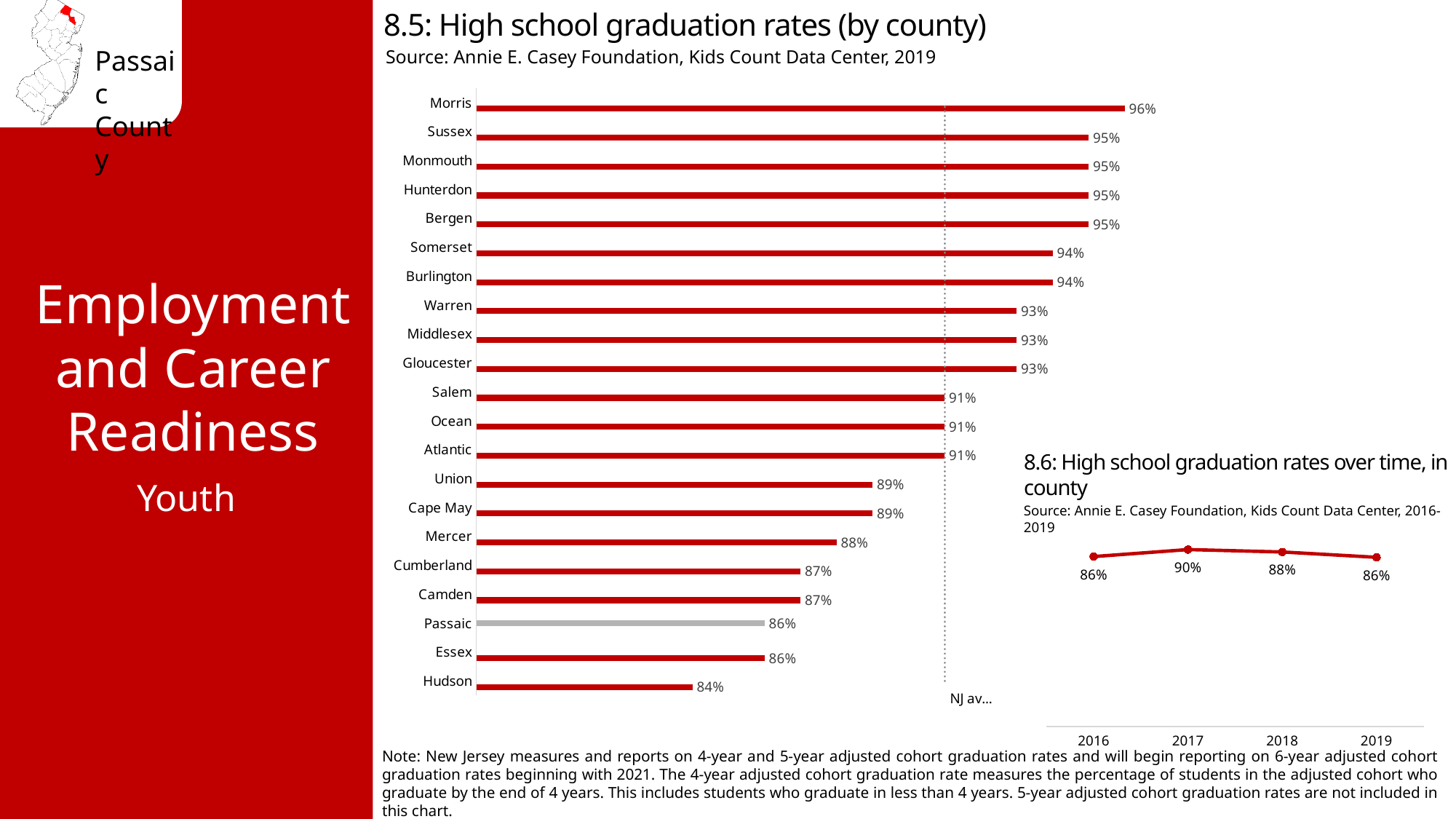
In the chart '8.5: High school graduation rates (by county)', what is the graduation rate for Somerset? 94% In the chart '8.6: High school graduation rates over time, in county', which year has the highest graduation rate? 2017 In the chart '8.6: High school graduation rates over time, in county', what is the difference between the 2017 and 2019 graduation rates? 4% In the chart '8.5: High school graduation rates (by county)', which county has the lowest graduation rate? Hudson In the chart '8.5: High school graduation rates (by county)', what is the graduation rate for Passaic? 86% In the chart '8.5: High school graduation rates (by county)', what is the difference between the graduation rates of Morris and Hudson? 12% What type of chart is '8.6: High school graduation rates over time, in county'? Line chart In the chart '8.5: High school graduation rates (by county)', which county has the highest graduation rate? Morris In the chart '8.6: High school graduation rates over time, in county', what is the graduation rate for 2017? 90% In the chart '8.5: High school graduation rates (by county)', which county has a higher graduation rate, Mercer or Camden? Mercer How many counties are shown in the chart '8.5: High school graduation rates (by county)'? 21 What type of chart is '8.5: High school graduation rates (by county)'? Bar chart